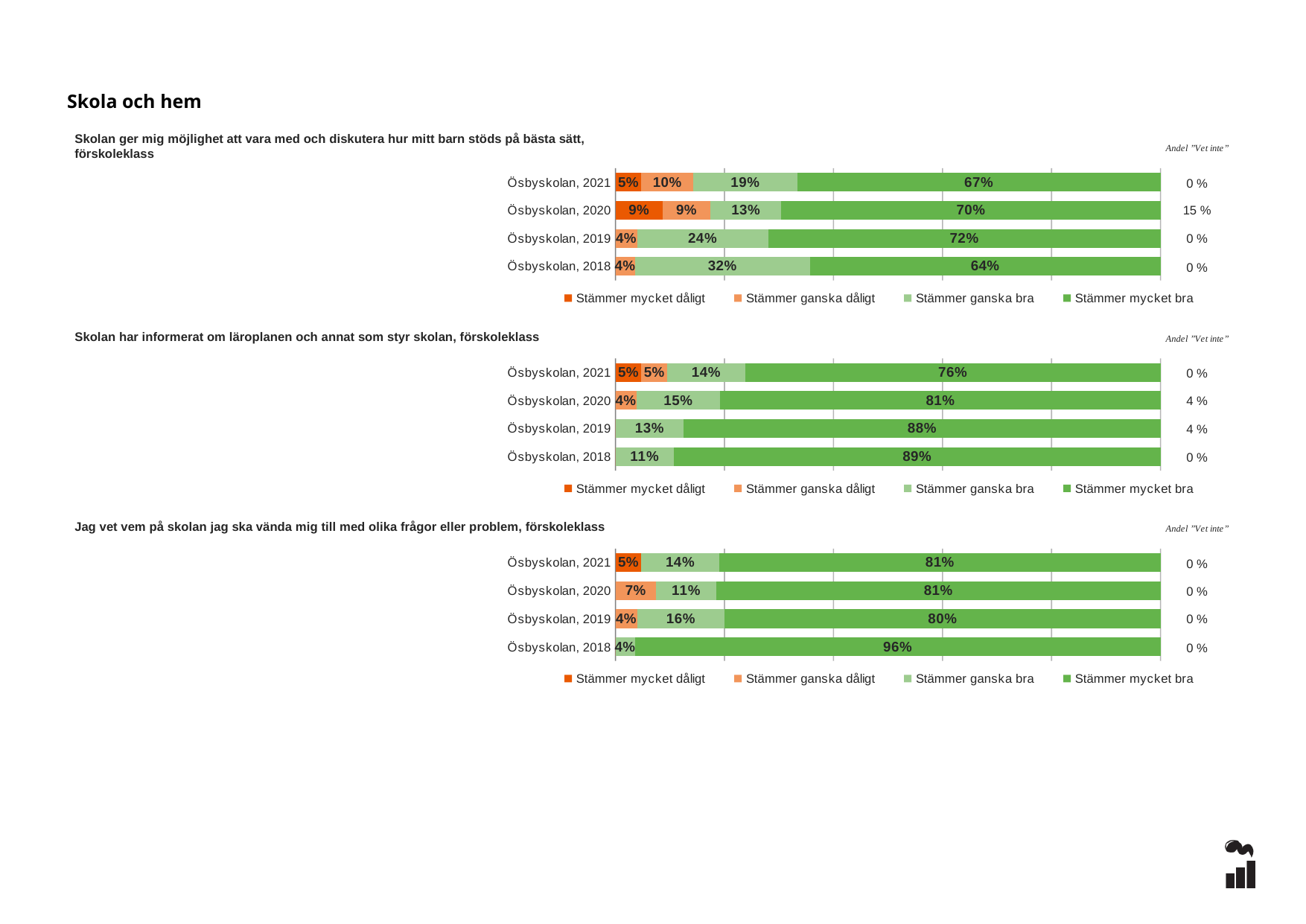
In the middle chart (Skolan har informerat om läroplanen och annat som styr skolan), which year has the lowest 'Stämmer mycket bra' value? Ösbyskolan, 2021 How many series does the legend of the top chart list? 4 What type of chart is the bottom chart (Jag vet vem på skolan jag ska vända mig till med olika frågor eller problem)? Stacked bar chart In the middle chart (Skolan har informerat om läroplanen och annat som styr skolan), what is the 'Stämmer mycket bra' value for Ösbyskolan, 2018? 89% In the top chart (Skolan ger mig möjlighet att vara med och diskutera hur mitt barn stöds på bästa sätt), what is the value of 'Stämmer mycket bra' for Ösbyskolan, 2020? 70% In the bottom chart (Jag vet vem på skolan jag ska vända mig till med olika frågor eller problem), what is the 'Stämmer mycket bra' value for Ösbyskolan, 2018? 96% In the middle chart (Skolan har informerat om läroplanen och annat som styr skolan), what is the difference between the 'Stämmer mycket bra' values for Ösbyskolan, 2019 and Ösbyskolan, 2021? 12% In the bottom chart (Jag vet vem på skolan jag ska vända mig till med olika frågor eller problem), is the 'Stämmer ganska bra' value larger for Ösbyskolan, 2019 or Ösbyskolan, 2020? Ösbyskolan, 2019 In the bottom chart (Jag vet vem på skolan jag ska vända mig till med olika frågor eller problem), what is the 'Stämmer ganska dåligt' value for Ösbyskolan, 2020? 7% In the top chart (Skolan ger mig möjlighet att vara med och diskutera hur mitt barn stöds på bästa sätt), what is the 'Stämmer ganska bra' value for Ösbyskolan, 2018? 32% In the top chart (Skolan ger mig möjlighet att vara med och diskutera hur mitt barn stöds på bästa sätt), which year has the highest 'Stämmer mycket bra' value? Ösbyskolan, 2019 In the top chart (Skolan ger mig möjlighet att vara med och diskutera hur mitt barn stöds på bästa sätt), what is the Andel 'Vet inte' value for Ösbyskolan, 2020? 15 %